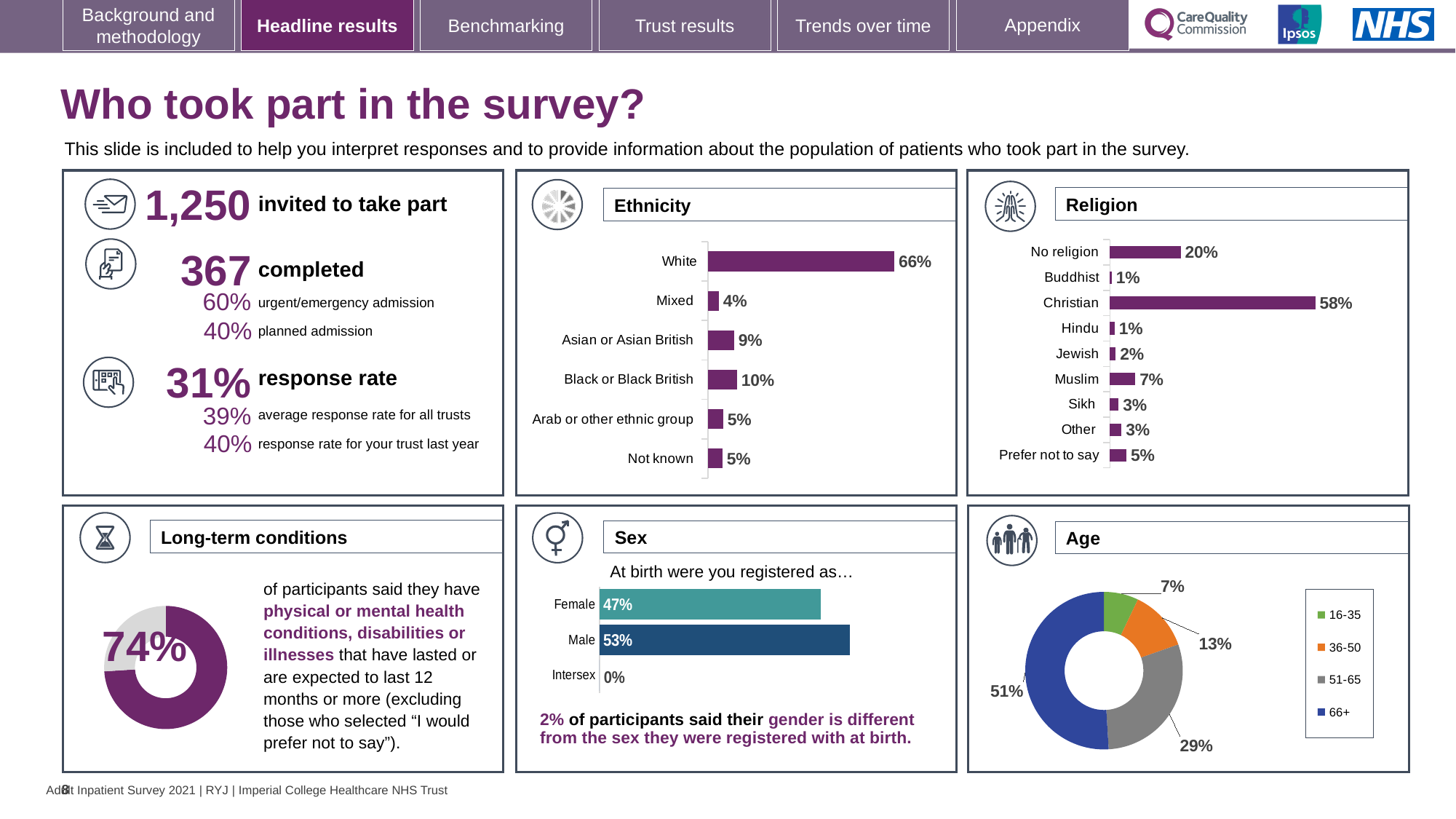
In the Age chart, what share of participants were aged 51-65? 29% In the Religion chart, how many religion categories are shown? 9 In the Religion chart, what percentage of participants were Christian? 58% In the Ethnicity chart, which ethnic group has the lowest percentage? Mixed In the Ethnicity chart, how many ethnic group categories are shown? 6 In the Age chart, which age group has the largest share? 66+ What kind of chart is the Age chart? Doughnut chart In the Religion chart, what is the difference between the percentage for Christian and the percentage for No religion? 38 percentage points In the Sex chart, what percentage of participants were registered as Male at birth? 53% In the Sex chart, what is the difference between the Male and Female percentages? 6 percentage points In the Religion chart, which is larger, the value for Muslim or the value for Sikh? Muslim In the Ethnicity chart, what percentage of participants were White? 66%